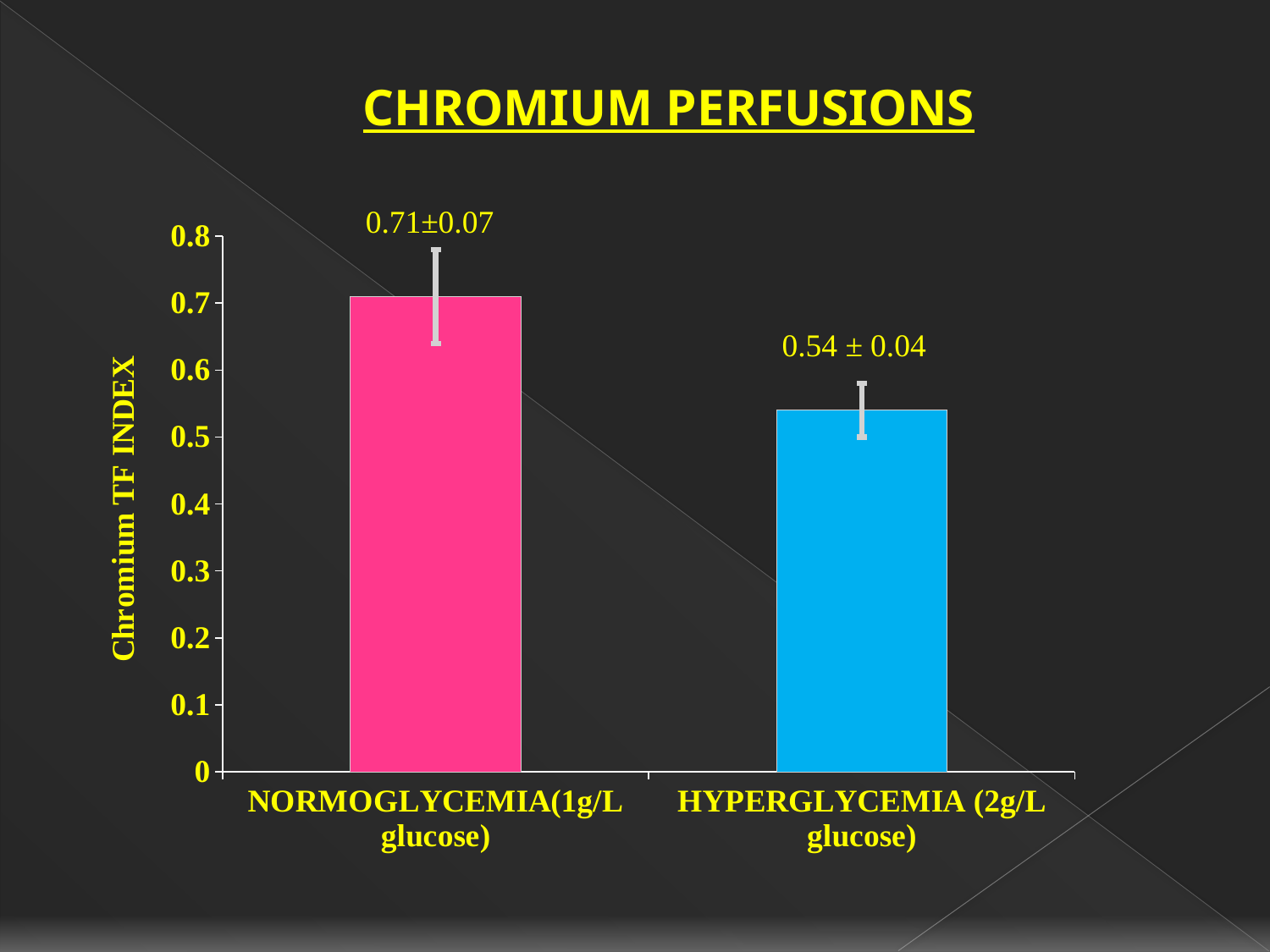
Is the value for NORMOGLYCEMIA (1g/L glucose) greater or less than 0.6? greater Is the Chromium TF Index larger for NORMOGLYCEMIA or for HYPERGLYCEMIA? NORMOGLYCEMIA What is the difference between the mean Chromium TF Index for NORMOGLYCEMIA and HYPERGLYCEMIA? 0.17 Which condition has the higher Chromium TF Index? NORMOGLYCEMIA (1g/L glucose) What is the Chromium TF Index value shown for HYPERGLYCEMIA (2g/L glucose)? 0.54 ± 0.04 Is the value for HYPERGLYCEMIA (2g/L glucose) greater or less than 0.6? less Which condition has the lower Chromium TF Index? HYPERGLYCEMIA (2g/L glucose) What is the Chromium TF Index value shown for NORMOGLYCEMIA (1g/L glucose)? 0.71±0.07 What kind of chart is shown on the slide? Bar chart How many categories are shown on the x axis? 2 What is the title of the slide? CHROMIUM PERFUSIONS What is the label of the y axis? Chromium TF INDEX